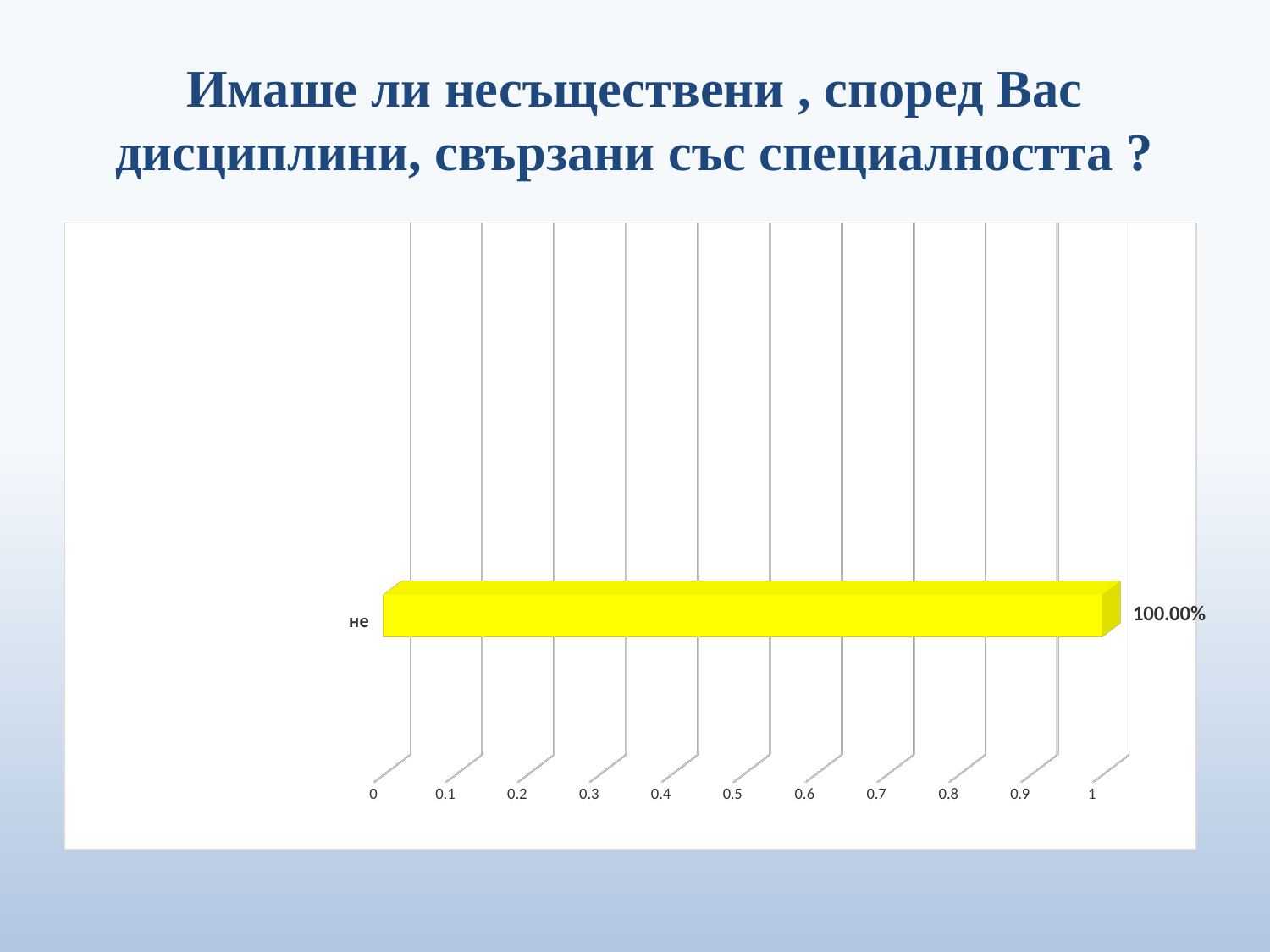
What kind of chart is shown on the slide? bar chart What colour is the bar on the chart? yellow How many categories are plotted on the chart? 1 What is the highest value shown on the horizontal axis? 1 Is the value for "не" greater or less than 0.5? greater What is the value shown for the category "не"? 100.00% What is the label of the only category on the chart? не